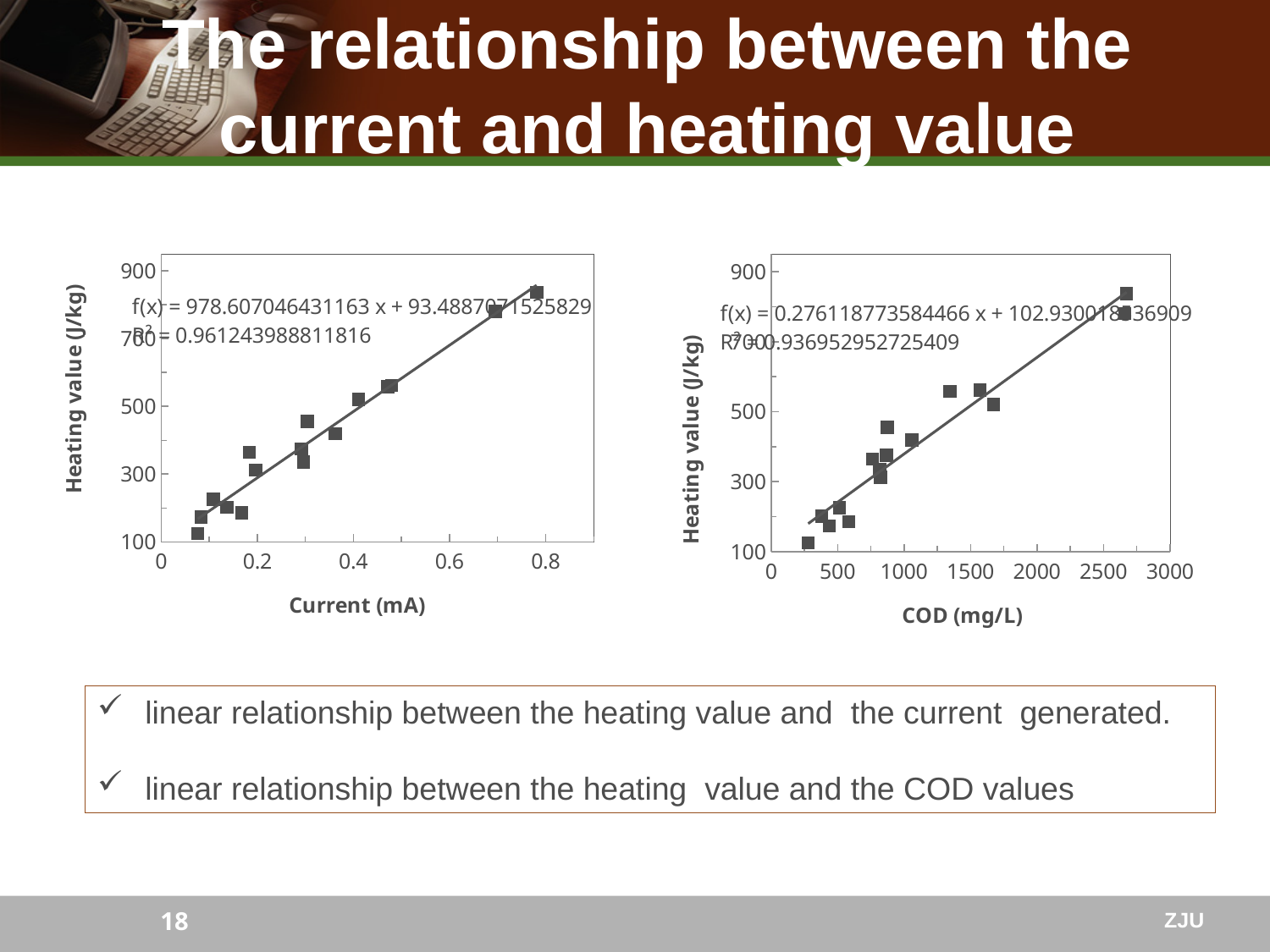
What kind of chart is the left chart (Current vs Heating value)? scatter chart In the left chart, does the heating value rise or fall as the current increases? rise What kind of chart is the right chart (COD vs Heating value)? scatter chart In the left chart, is the heating value of the point at the highest current (about 0.8 mA) greater or less than 700? greater What R² value is shown on the left chart (Current vs Heating value)? 0.961243988811816 In the right chart, is the heating value of the point at about 1700 mg/L COD greater or less than 300? greater In the right chart, does the heating value rise or fall as COD increases? rise In the right chart, is the heating value of the point at the highest COD (about 2650 mg/L) greater or less than 700? greater What is the x-axis title of the right chart? COD (mg/L)